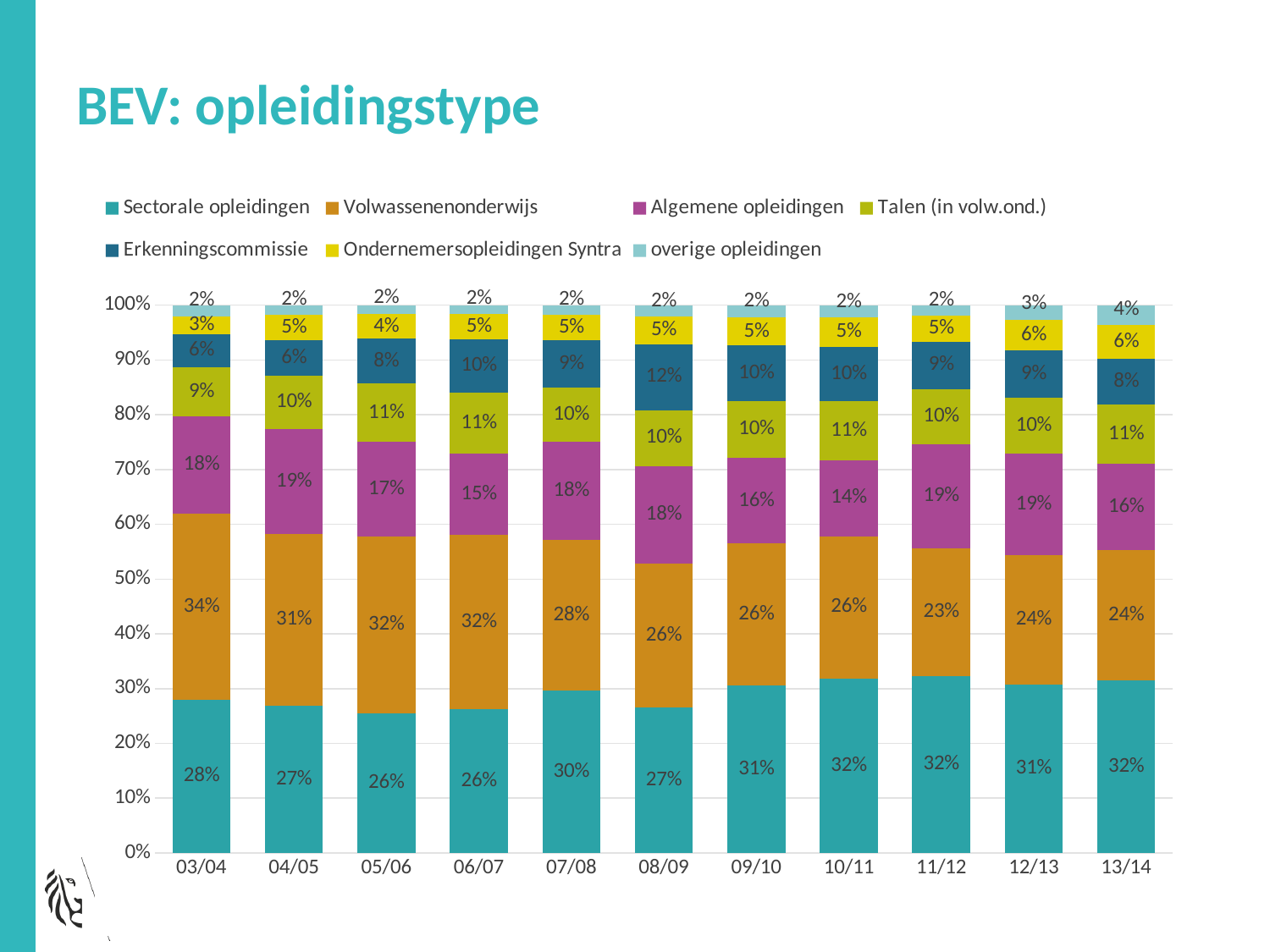
What is the share of Sectorale opleidingen in 13/14? 32% How many school years are shown on the x axis? 11 How many series does the legend list? 7 What is the share of Erkenningscommissie in 08/09? 12% In 13/14, which is larger: the share of Sectorale opleidingen or Volwassenenonderwijs? Sectorale opleidingen In which year is the share of Ondernemersopleidingen Syntra the lowest? 03/04 In which year is the share of overige opleidingen the highest? 13/14 By how many percentage points did the share of Volwassenenonderwijs fall from 03/04 to 13/14? 10 percentage points In which year is the share of Volwassenenonderwijs the highest? 03/04 What is the share of Volwassenenonderwijs in 03/04? 34% What type of chart is shown on the slide? Stacked bar chart Does the share of Volwassenenonderwijs generally rise or fall from 03/04 to 13/14? Fall